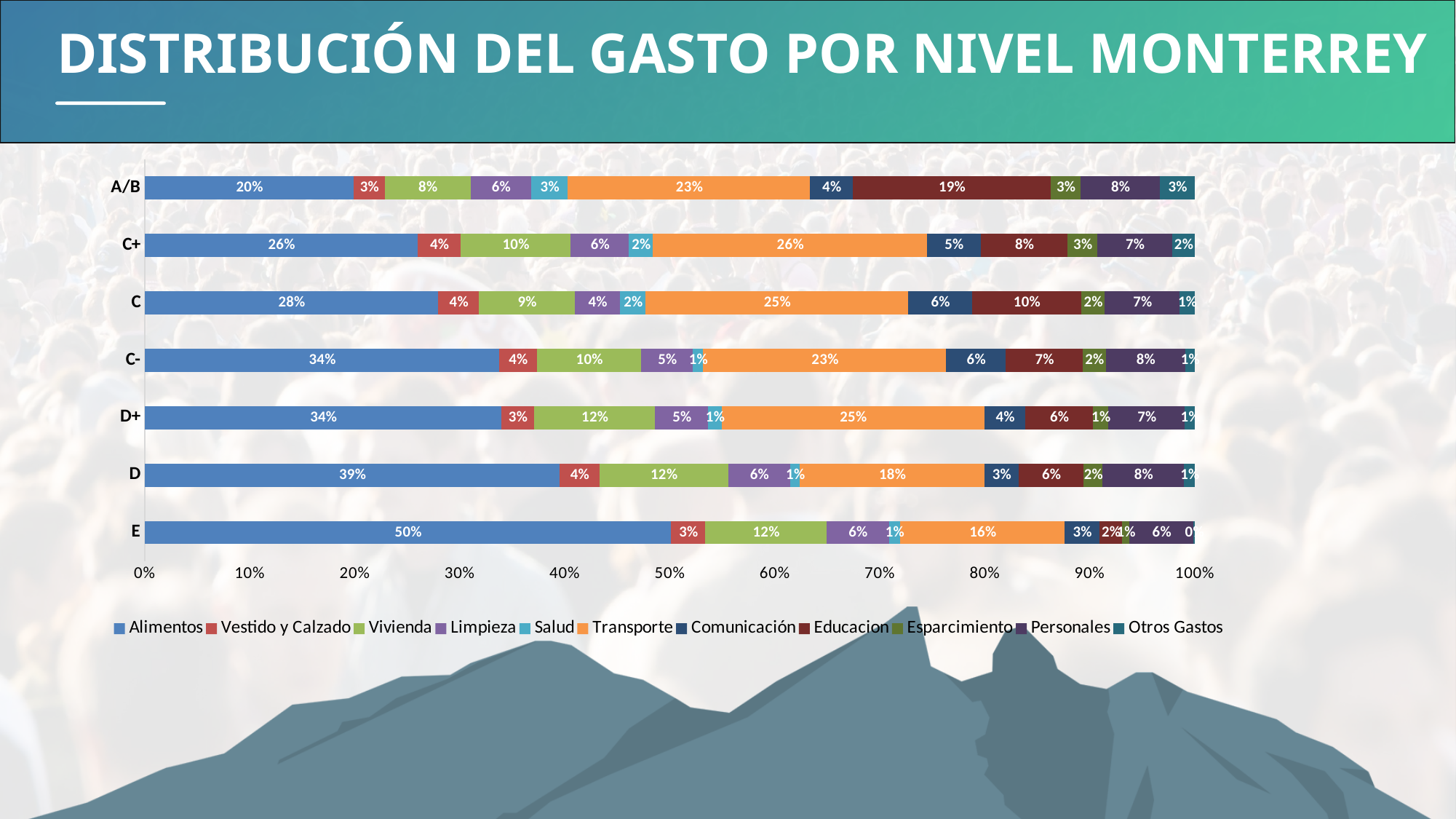
What share of spending goes to Educacion for level A/B? 19% Which is larger: the Transporte share for level C or the Transporte share for level D? Level C Which level has the lowest share of spending on Alimentos? A/B How many series does the legend list? 11 What type of chart is shown on the slide? Stacked bar chart What share of spending goes to Alimentos for level E? 50% How many socioeconomic levels (categories) are shown on the chart? 7 What is the title of the chart on the slide? DISTRIBUCIÓN DEL GASTO POR NIVEL MONTERREY What share of spending goes to Transporte for level C+? 26% What share of spending goes to Vivienda for level D? 12% What is the difference in the Alimentos share between level E and level A/B? 30 percentage points Which level has the highest share of spending on Alimentos? E